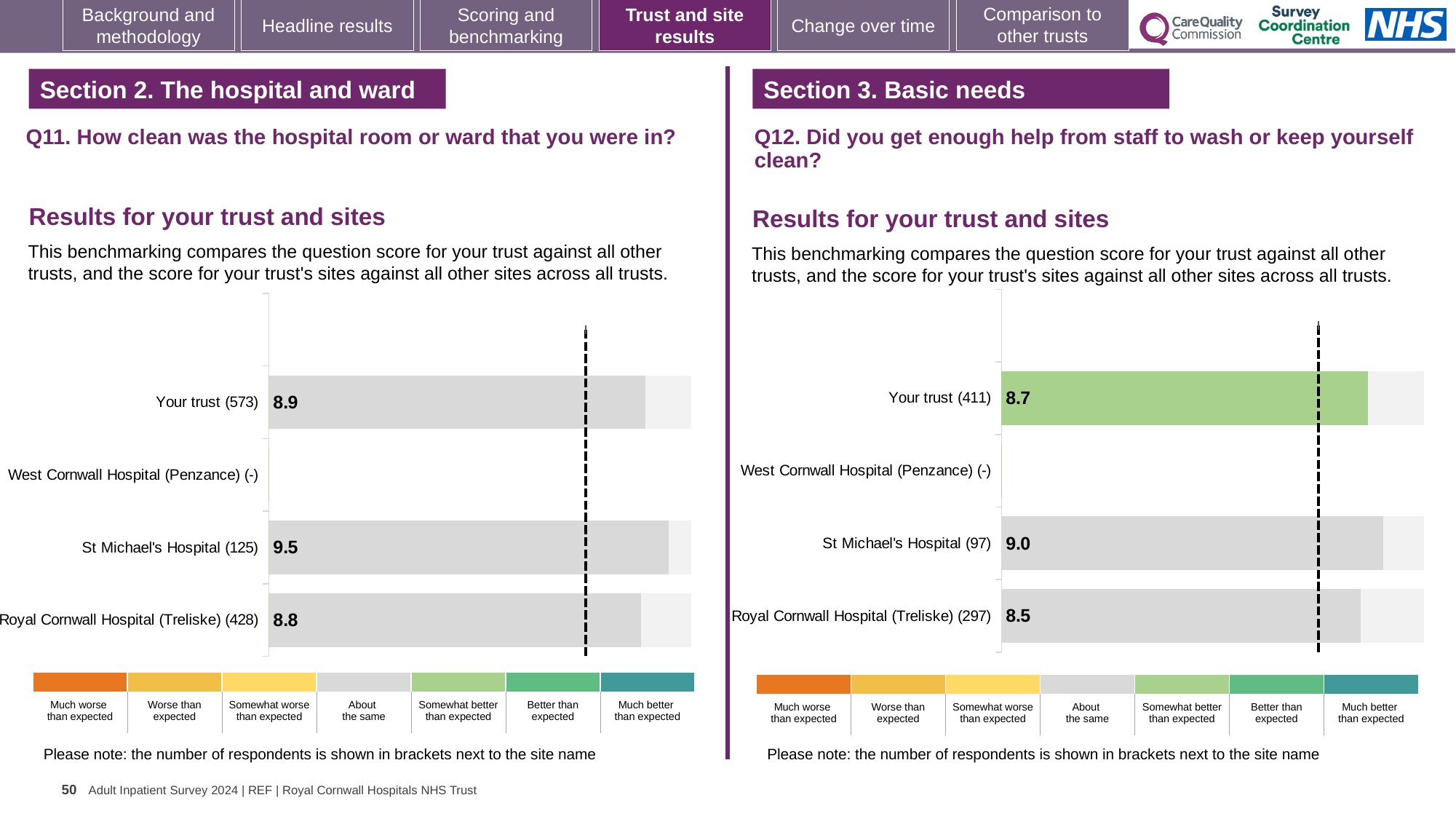
On the Q12 chart (right), what is the score for Your trust (411)? 8.7 On the Q12 chart (right), what is the score for Royal Cornwall Hospital (Treliske) (297)? 8.5 On the Q12 chart (right), which row has the lowest printed score? Royal Cornwall Hospital (Treliske) (297) On the Q11 chart (left), how many rows (categories) are listed on the vertical axis? 4 What type of chart is used on the Q11 chart (left)? bar chart On the Q11 chart (left), what is the difference between the scores for St Michael's Hospital (125) and Royal Cornwall Hospital (Treliske) (428)? 0.7 On the Q11 chart (left), what is the score for St Michael's Hospital (125)? 9.5 On the Q11 chart (left), which site or trust row has the highest score? St Michael's Hospital (125) On the Q12 chart (right), what is the difference between the scores for St Michael's Hospital (97) and Royal Cornwall Hospital (Treliske) (297)? 0.5 On the Q12 chart (right), which benchmark category does the green colour of the Your trust (411) bar correspond to in the key? Somewhat better than expected On the Q11 chart (left), what is the score for Your trust (573)? 8.9 On the Q12 chart (right), is the score for St Michael's Hospital (97) larger or smaller than the score for Your trust (411)? larger